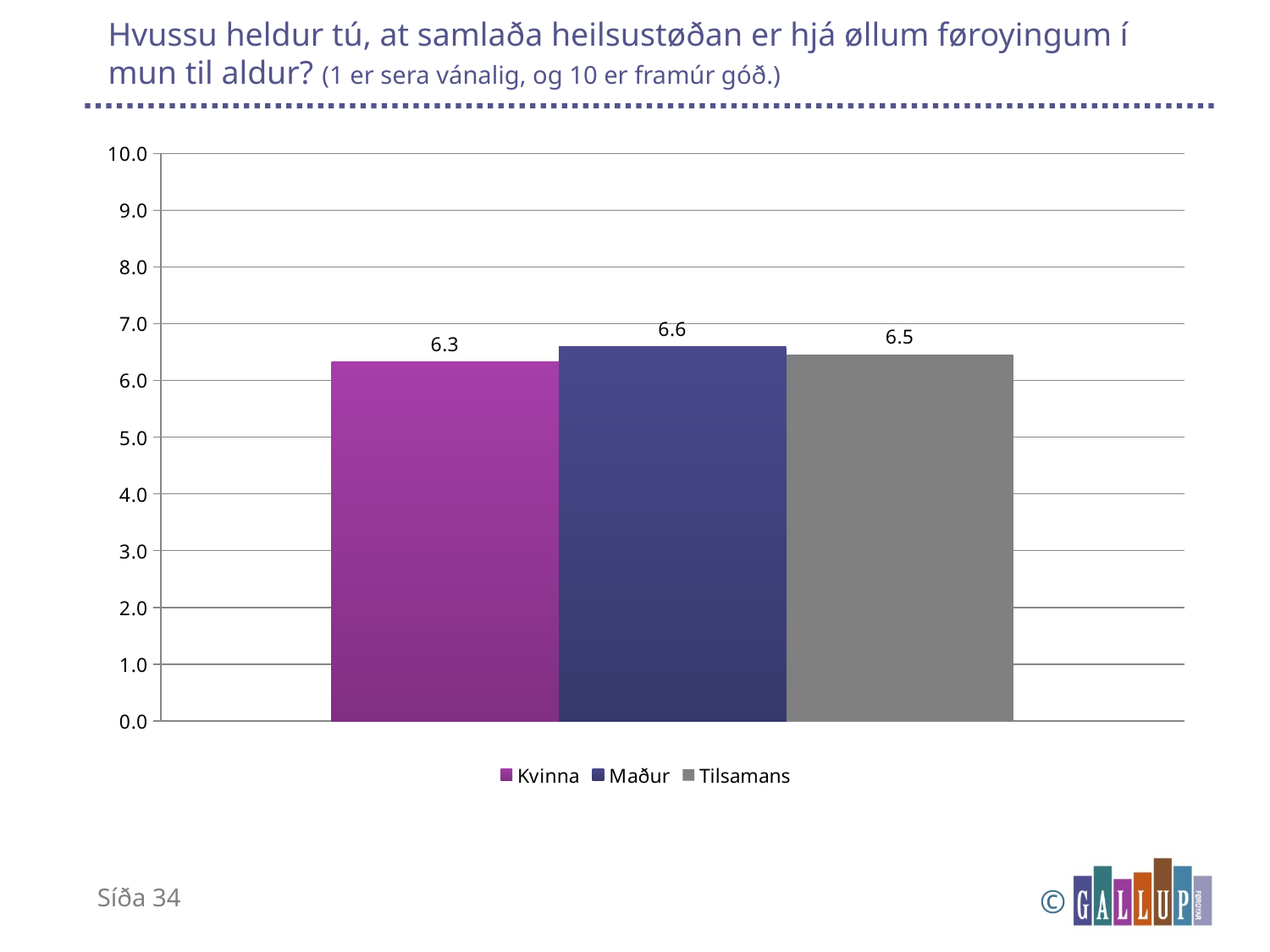
Which series has the lowest value? Kvinna How many bars are plotted in the chart? 3 Which series has the highest value? Maður How many series does the legend list? 3 Which is larger, the value for Maður or the value for Kvinna? Maður Is the value for Tilsamans greater or less than 7.0? less What is the value for Maður? 6.6 What is the value for Tilsamans? 6.5 What colour is the bar for Kvinna? purple What is the difference between the values for Maður and Kvinna? 0.3 What is the value for Kvinna? 6.3 What kind of chart is shown on the slide? bar chart